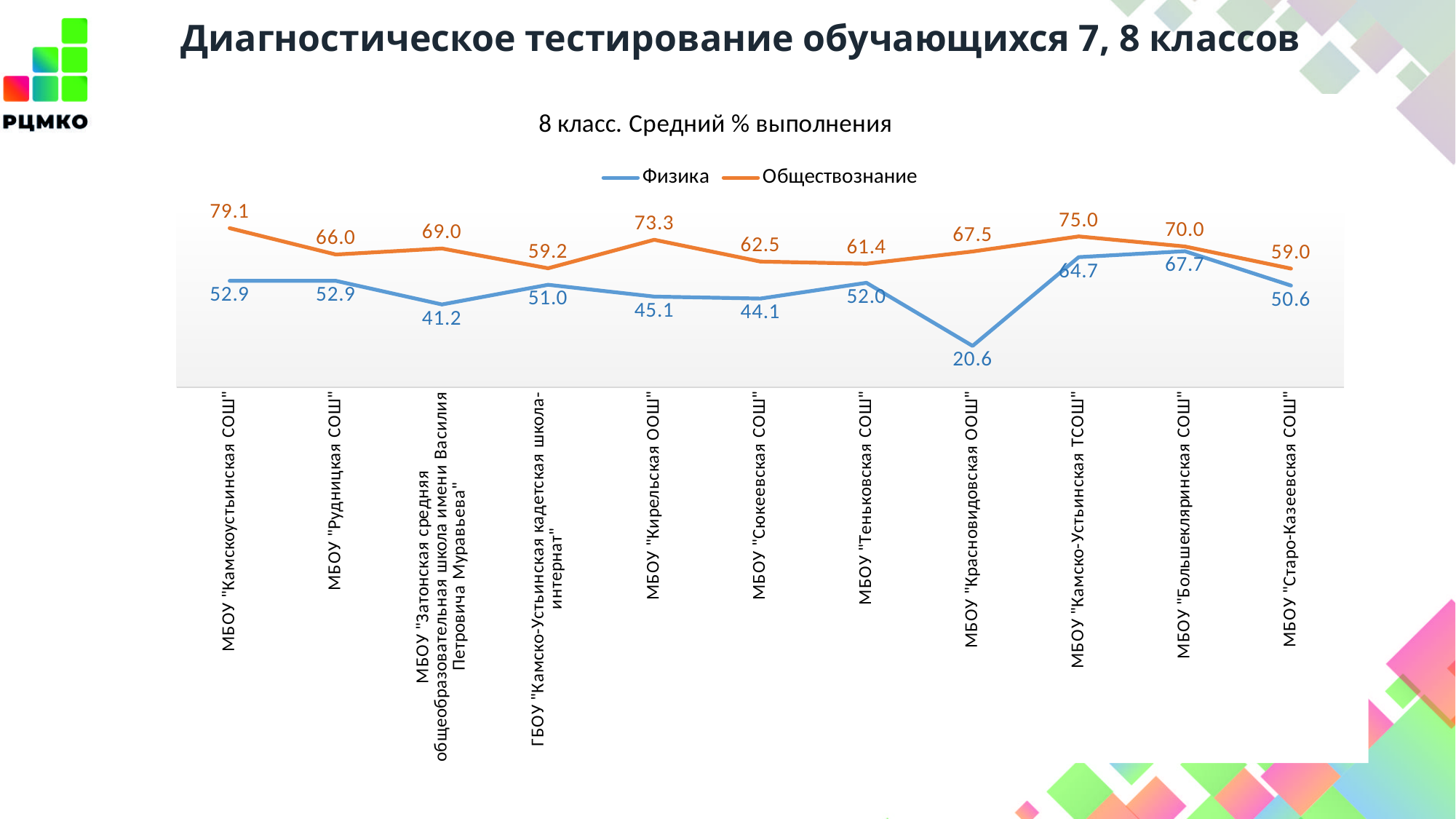
Which colour represents the Обществознание series? orange How many schools (categories) are plotted on the x axis? 11 What is the title of the chart? 8 класс. Средний % выполнения Which school has the highest Обществознание value? МБОУ "Камскоустьинская СОШ" How many series does the legend list? 2 Which school has the highest Физика value? МБОУ "Большекляринская СОШ" What type of chart is shown on the slide? line chart Which school has the lowest Физика value? МБОУ "Красновидовская ООШ" What is the Обществознание value for МБОУ "Кирельская ООШ"? 73.3 Which is larger for МБОУ "Старо-Казеевская СОШ": the Физика value or the Обществознание value? Обществознание What is the difference between the Обществознание and Физика values for МБОУ "Камскоустьинская СОШ"? 26.2 What is the Физика value for МБОУ "Красновидовская ООШ"? 20.6